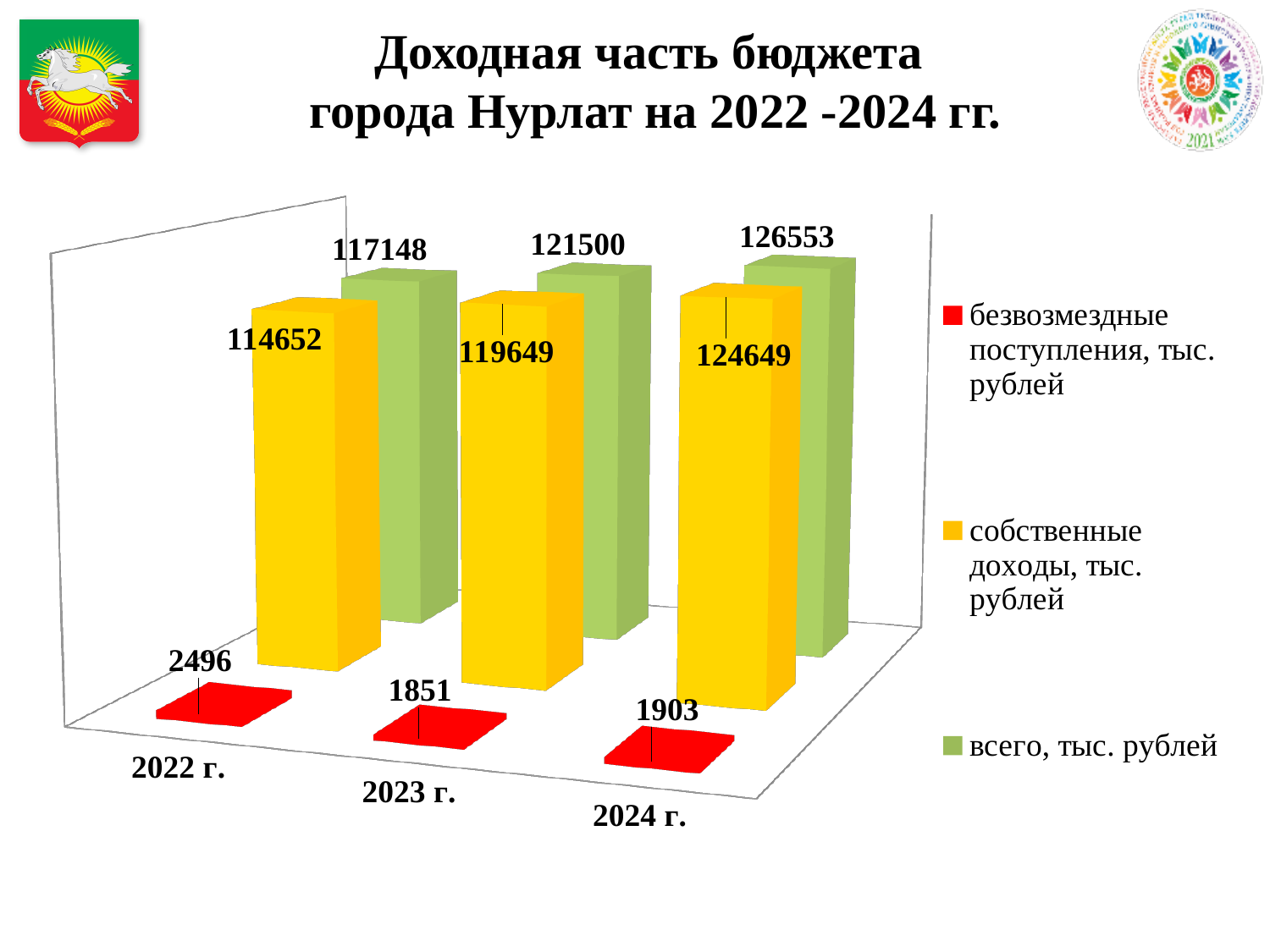
In which year is всего, тыс. рублей the highest? 2024 г. What is the value of собственные доходы, тыс. рублей for 2022 г.? 114652 What is the difference between собственные доходы, тыс. рублей in 2024 г. and in 2022 г.? 9997 What colour represents всего, тыс. рублей in the chart? green What is the value of безвозмездные поступления, тыс. рублей for 2023 г.? 1851 How many series does the legend list? 3 What kind of chart is shown on the slide? bar chart How many years are shown on the x axis of the chart? 3 Which is larger: безвозмездные поступления, тыс. рублей in 2022 г. or in 2024 г.? 2022 г. Do the values of собственные доходы, тыс. рублей rise or fall from 2022 г. to 2024 г.? rise In which year is безвозмездные поступления, тыс. рублей the lowest? 2023 г. What is the value of всего, тыс. рублей for 2024 г.? 126553